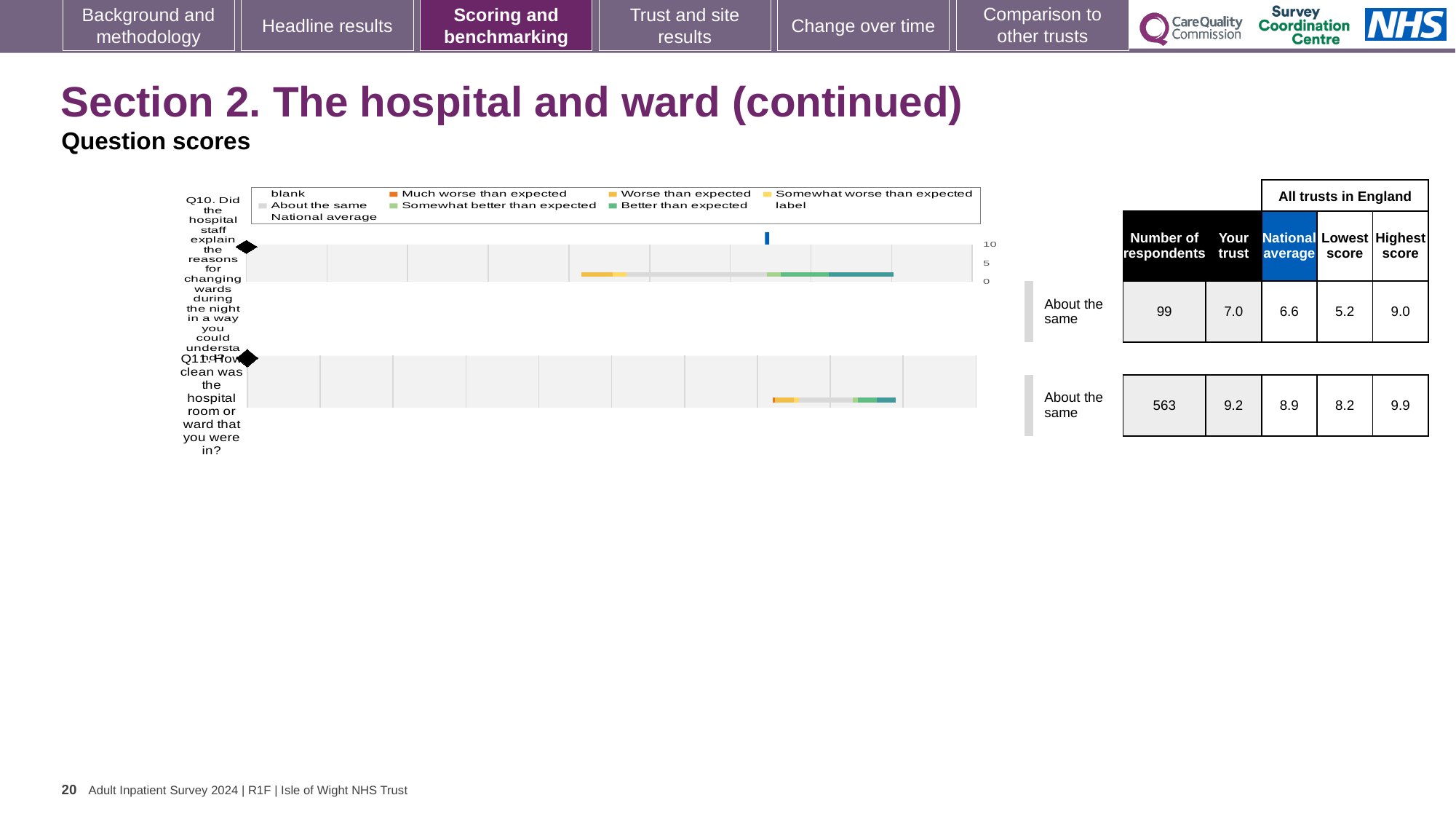
What is the lowest score among all trusts in England for Q10? 5.2 What benchmark category is given for Q11? About the same What is the 'Your trust' score for Q10 (explaining reasons for changing wards during the night)? 7.0 What is the 'Your trust' score for Q11 (how clean was the hospital room or ward)? 9.2 Which question has the higher 'Your trust' score, Q10 or Q11? Q11 What is the national average score for Q11? 8.9 How many survey questions are plotted on the slide? 2 How many respondents answered Q10? 99 What kind of chart is used to show the question scores for Q10 and Q11? bar chart What is the highest tick value shown on the axis of the Q10 chart? 10 Which legend entry is shown in orange in the chart legend? Much worse than expected What is the difference between the 'Your trust' scores for Q11 and Q10? 2.2